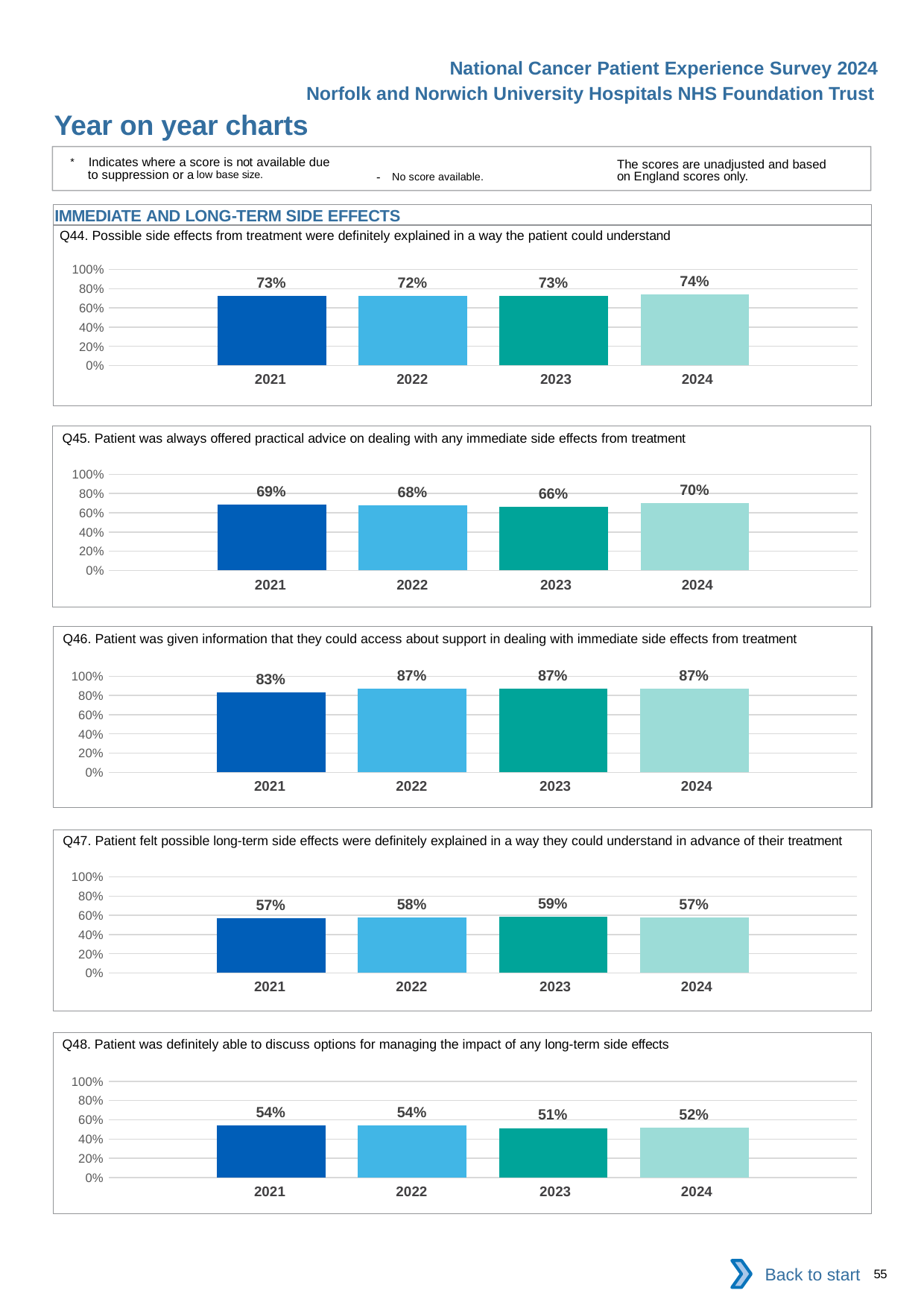
In the Q46 chart, what is the difference between the 2022 value and the 2021 value? 4% In the Q45 chart, which year has the lowest value? 2023 How many bars are shown in the Q46 chart? 4 In the Q45 chart, what is the difference between the 2024 value and the 2023 value? 4% In the Q47 chart, is the value for 2021 greater or less than 60%? less In the Q48 chart, is the value for 2023 larger or smaller than the value for 2021? smaller What type of chart is used for Q44? bar chart In the Q44 chart, what is the value for 2024? 74% In the Q47 chart, which year has the highest value? 2023 In the Q48 chart, what is the value for 2024? 52% In the Q45 chart, what is the value for 2022? 68% In the Q46 chart, is the value for 2023 greater or less than 80%? greater